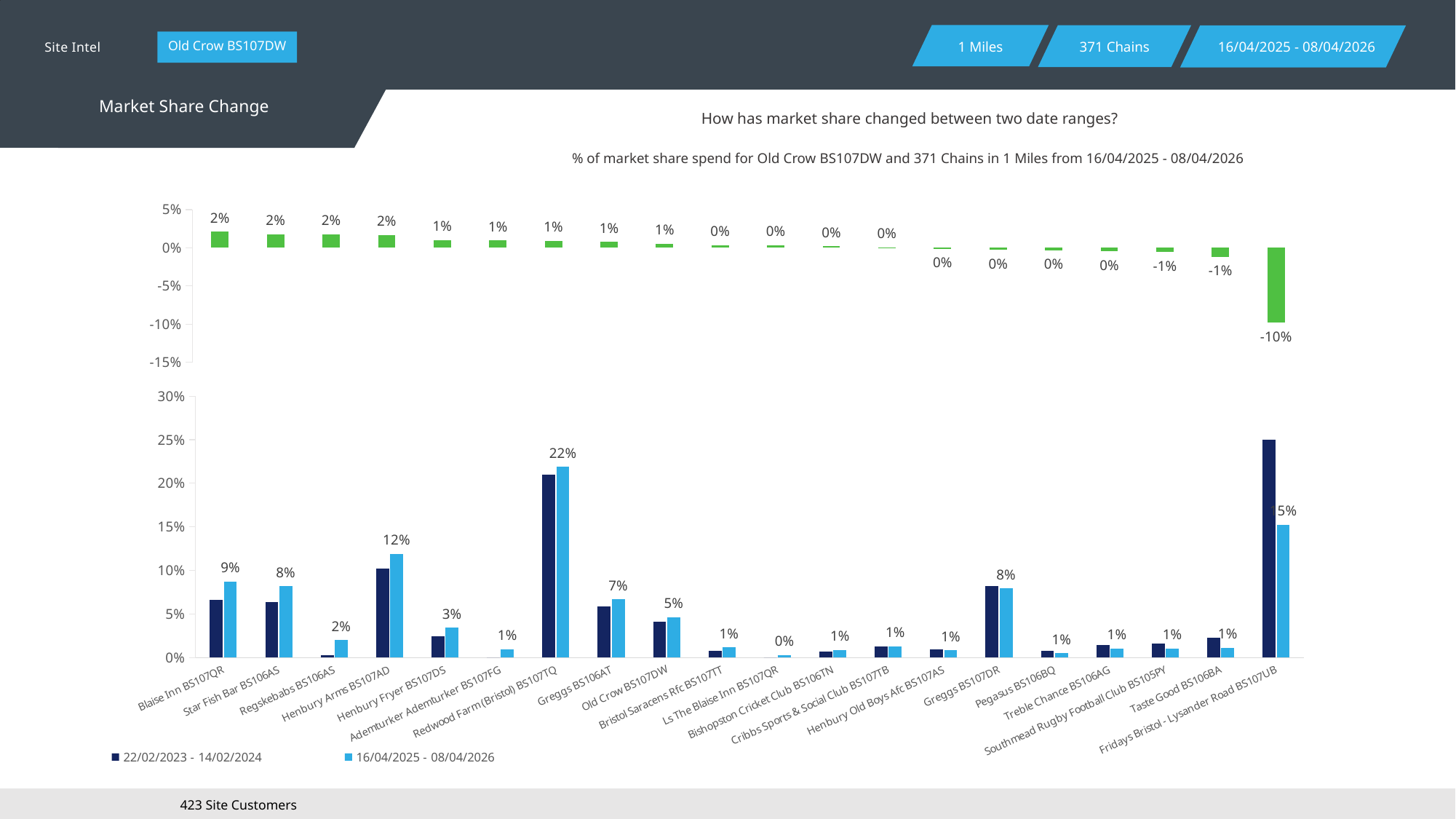
In the top chart (market share change), what is the lowest value shown? -10% What kind of chart is the bottom chart? bar chart In the bottom chart, which has the larger 16/04/2025 - 08/04/2026 market share: Blaise Inn BS107QR or Star Fish Bar BS106AS? Blaise Inn BS107QR In the bottom chart, what is the market share for Henbury Arms BS107AD in the 16/04/2025 - 08/04/2026 period? 12% In the bottom chart, what is the market share for Old Crow BS107DW in the 16/04/2025 - 08/04/2026 period? 5% In the bottom chart, what is the market share for Redwood Farm (Bristol) BS107TQ in the 16/04/2025 - 08/04/2026 period? 22% In the bottom chart, is the 22/02/2023 - 14/02/2024 value for Fridays Bristol - Lysander Road BS107UB greater or less than 20%? greater What are the two legend entries of the bottom chart? 22/02/2023 - 14/02/2024 and 16/04/2025 - 08/04/2026 In the bottom chart, which category has the highest market share in the 16/04/2025 - 08/04/2026 period? Redwood Farm (Bristol) BS107TQ In the bottom chart, what is the difference between the 16/04/2025 - 08/04/2026 market share of Redwood Farm (Bristol) BS107TQ and Fridays Bristol - Lysander Road BS107UB? 7% How many series does the legend of the bottom chart list? 2 How many categories are shown on the x axis of the bottom chart? 20